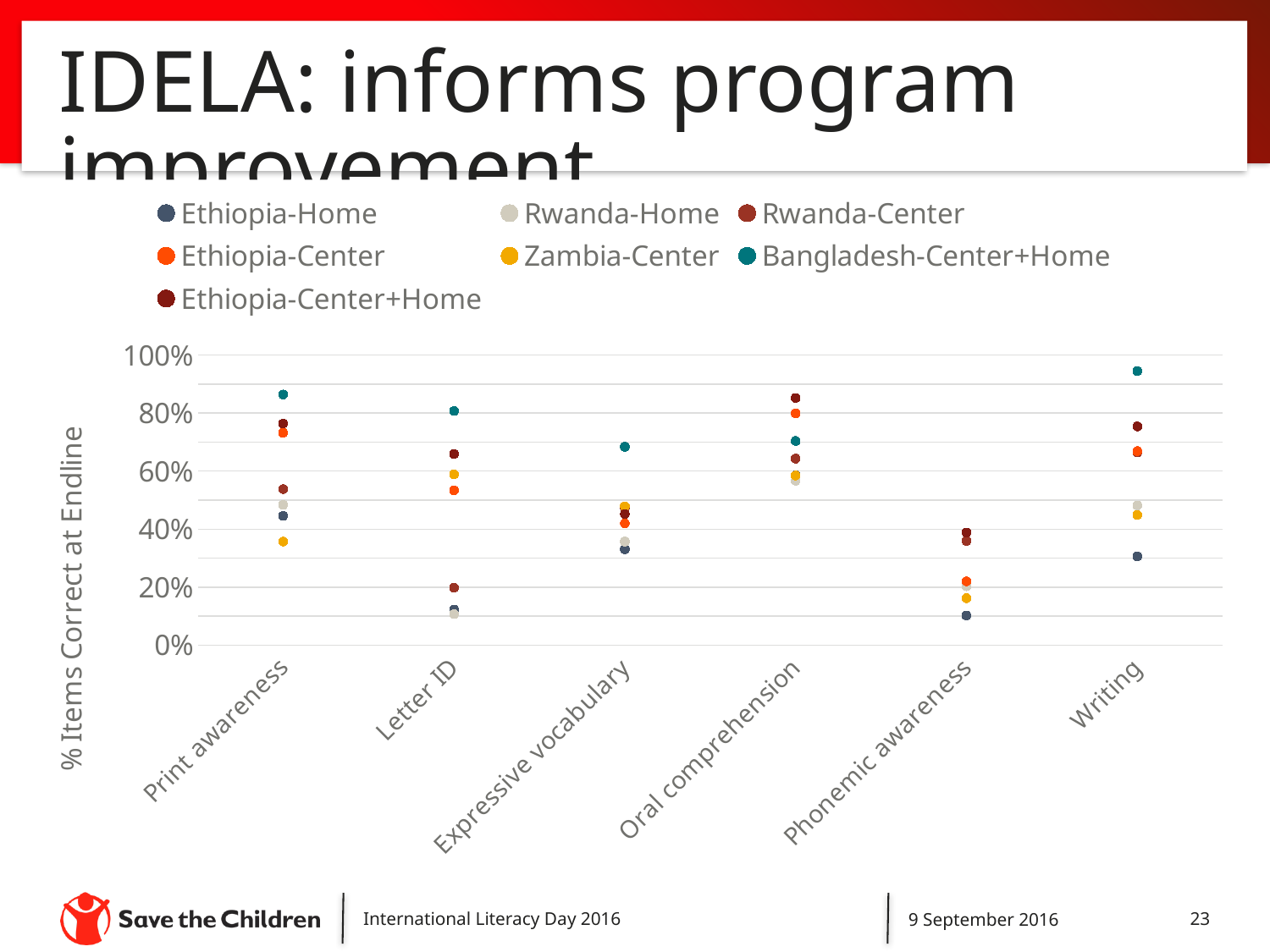
Is the value for Ethiopia-Home in Phonemic awareness greater or less than 20%? less What kind of chart is shown on the slide? Scatter (dot) chart What is the label on the y axis? % Items Correct at Endline Which series has the highest value for Print awareness? Bangladesh-Center+Home Which series has the highest value for Writing? Bangladesh-Center+Home Which series has the highest value for Oral comprehension? Ethiopia-Center+Home Which series has the lowest value for Phonemic awareness? Ethiopia-Home For Oral comprehension, which is larger: Ethiopia-Center+Home or Bangladesh-Center+Home? Ethiopia-Center+Home Which series has the lowest value for Print awareness? Zambia-Center Is the value for Bangladesh-Center+Home in Writing greater or less than 80%? greater How many categories are shown along the x axis? 6 How many series does the legend list? 7